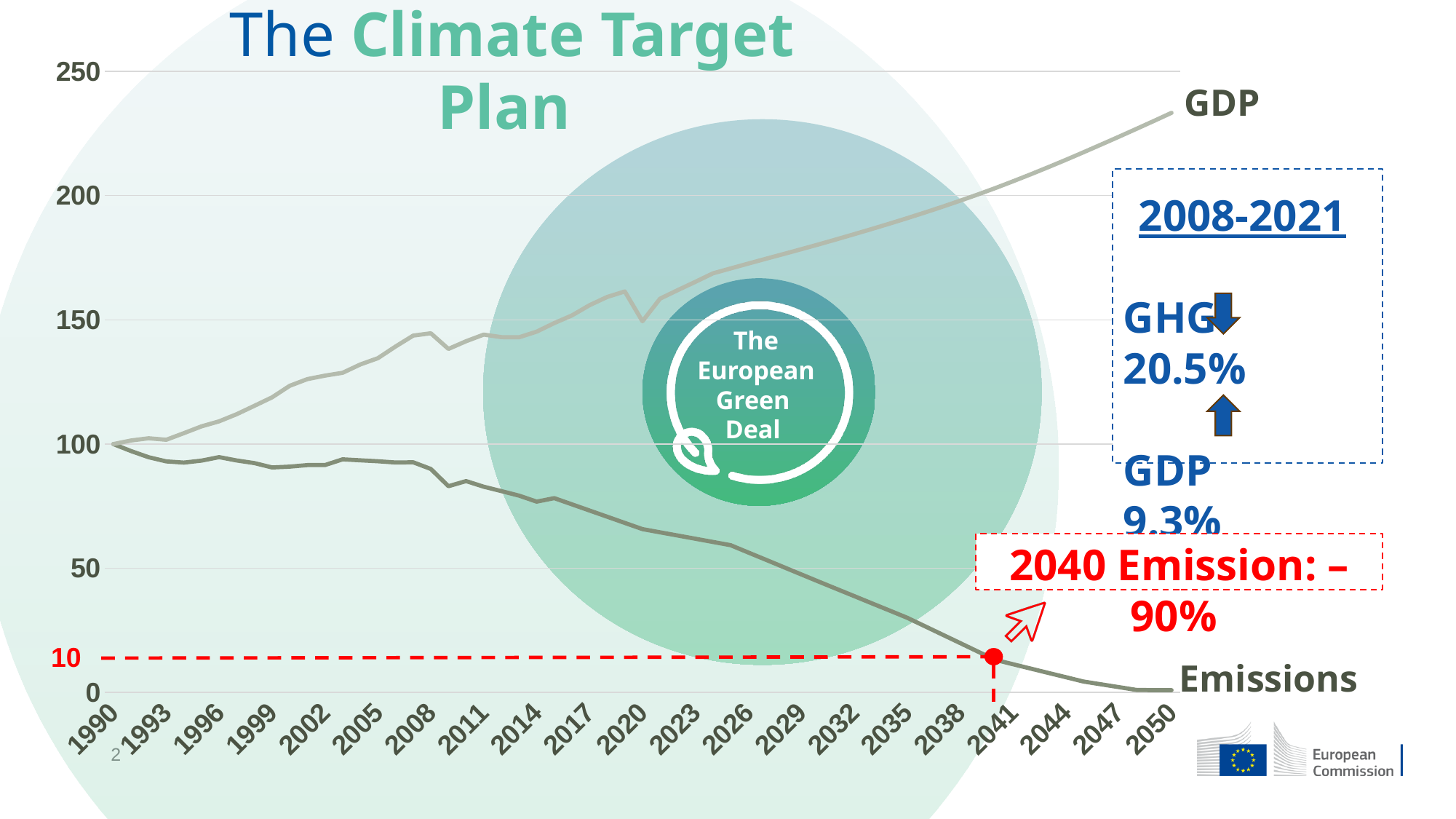
What value do both the GDP and Emissions lines start at in 1990? 100 Is the Emissions value in 2050 greater or less than 50? less What are the names of the two lines plotted on the chart? GDP and Emissions What type of chart is shown on the slide? line chart In 2050, which line has the higher value, GDP or Emissions? GDP How many year labels are shown on the x axis? 21 Does the GDP line rise or fall from 1990 to 2050? rise How many data series (lines) are plotted on the chart? 2 Is the Emissions value in 2026 greater or less than 50? greater Does the Emissions line rise or fall from 1990 to 2050? fall What value does the red dashed horizontal line mark on the y axis? 10 Is the GDP value in 2050 greater or less than 200? greater